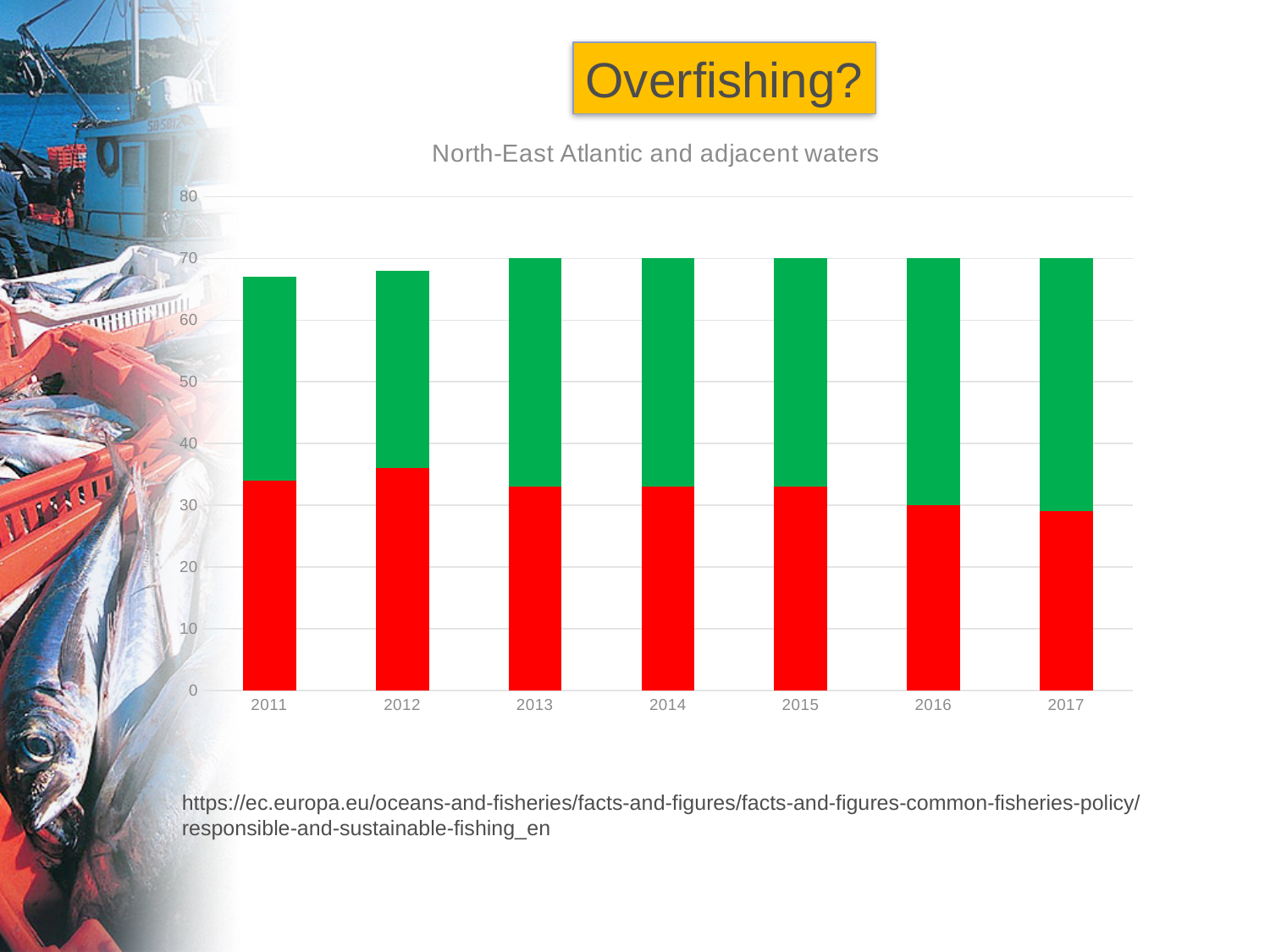
Is the total height of the 2011 bar greater or less than 60? greater From 2013 to 2017, does the red segment rise or fall? fall What is the title of the chart? North-East Atlantic and adjacent waters How many years are shown on the x axis of the chart? 7 Is the red segment for 2012 greater or less than 30? greater What kind of chart is shown on the slide? Stacked bar chart Is the red segment for 2013 greater or less than 40? less Which is larger, the red segment for 2012 or the red segment for 2016? 2012 What two colours are used for the segments of the stacked bars? Red and green Which year has the tallest red segment? 2012